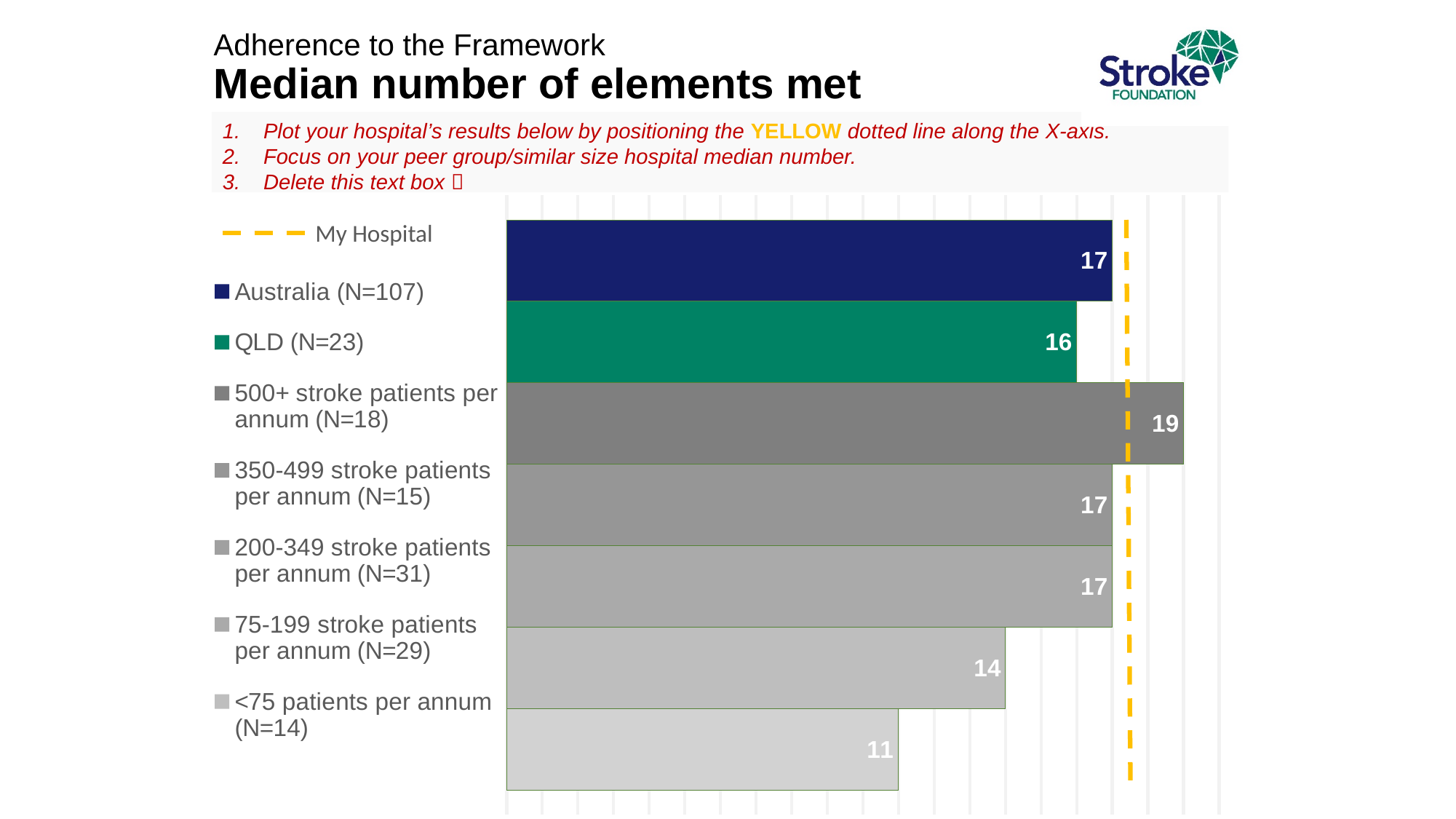
How many bars are plotted in the chart? 7 What does the yellow dotted line in the legend represent? My Hospital What kind of chart is shown on the slide? Bar chart Which group has the highest median number of elements met? 500+ stroke patients per annum (N=18) What is the difference between the median number of elements met for 500+ stroke patients per annum and <75 patients per annum? 8 What is the median number of elements met for QLD (N=23)? 16 What is the median number of elements met for hospitals with <75 patients per annum (N=14)? 11 What is the difference between the median number of elements met for Australia (N=107) and QLD (N=23)? 1 Which group has the lowest median number of elements met? <75 patients per annum (N=14) What is the median number of elements met for Australia (N=107)? 17 What is the median number of elements met for hospitals with 500+ stroke patients per annum (N=18)? 19 Which has a higher median number of elements met: QLD (N=23) or 75-199 stroke patients per annum (N=29)? QLD (N=23)